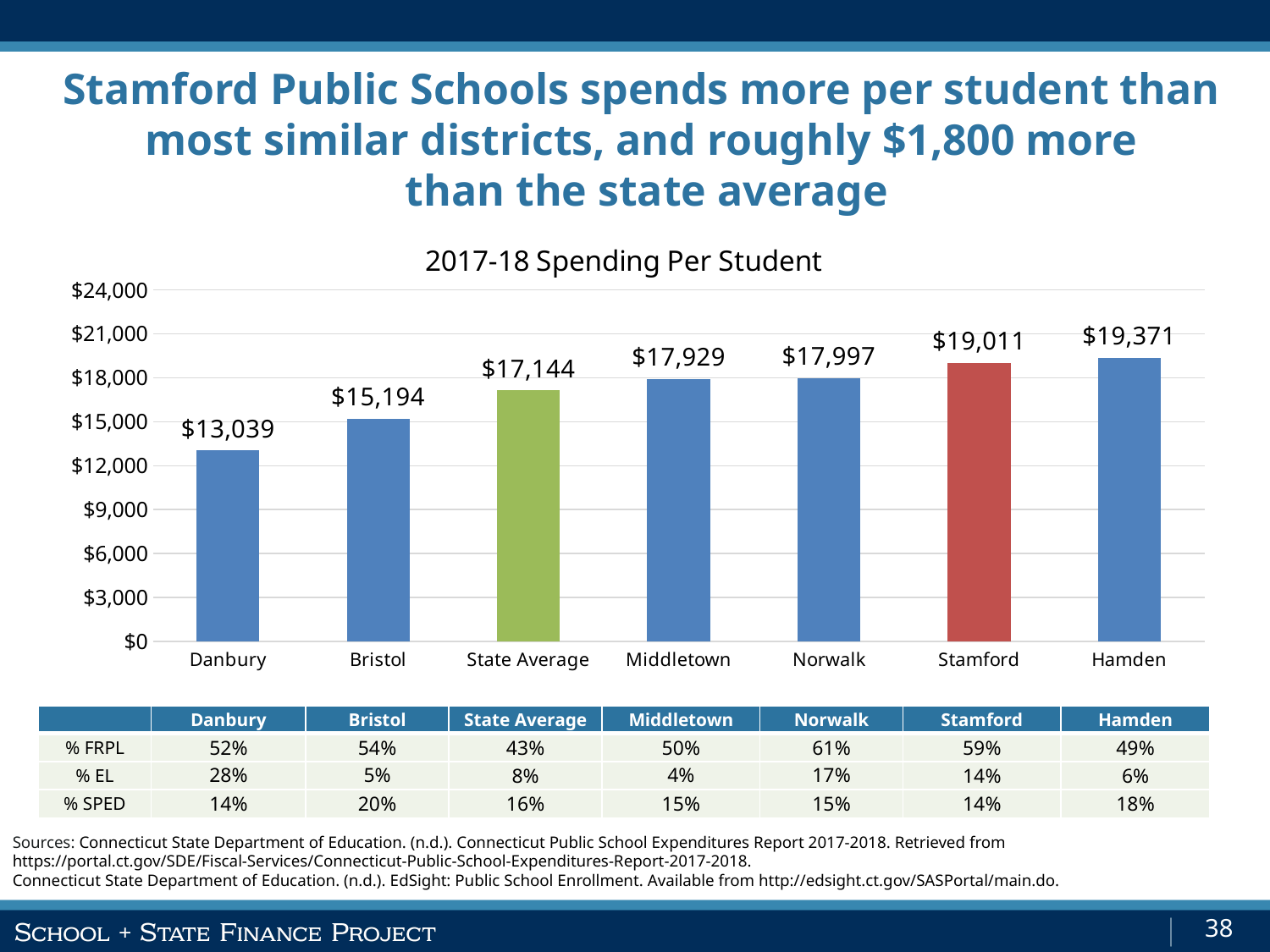
What is the title of the chart? 2017-18 Spending Per Student What is the 2017-18 spending per student for Stamford? $19,011 What is the difference in spending per student between Stamford and the State Average? $1,867 What is the 2017-18 spending per student for the State Average? $17,144 What type of chart is shown on the slide? Bar chart Which district has the highest spending per student in the chart? Hamden What is the 2017-18 spending per student for Danbury? $13,039 Which spends more per student, Bristol or Middletown? Middletown Is the spending per student for Norwalk greater or less than $15,000? greater Which district has the lowest spending per student in the chart? Danbury What is the difference in spending per student between Hamden and Stamford? $360 How many bars are shown in the chart? 7